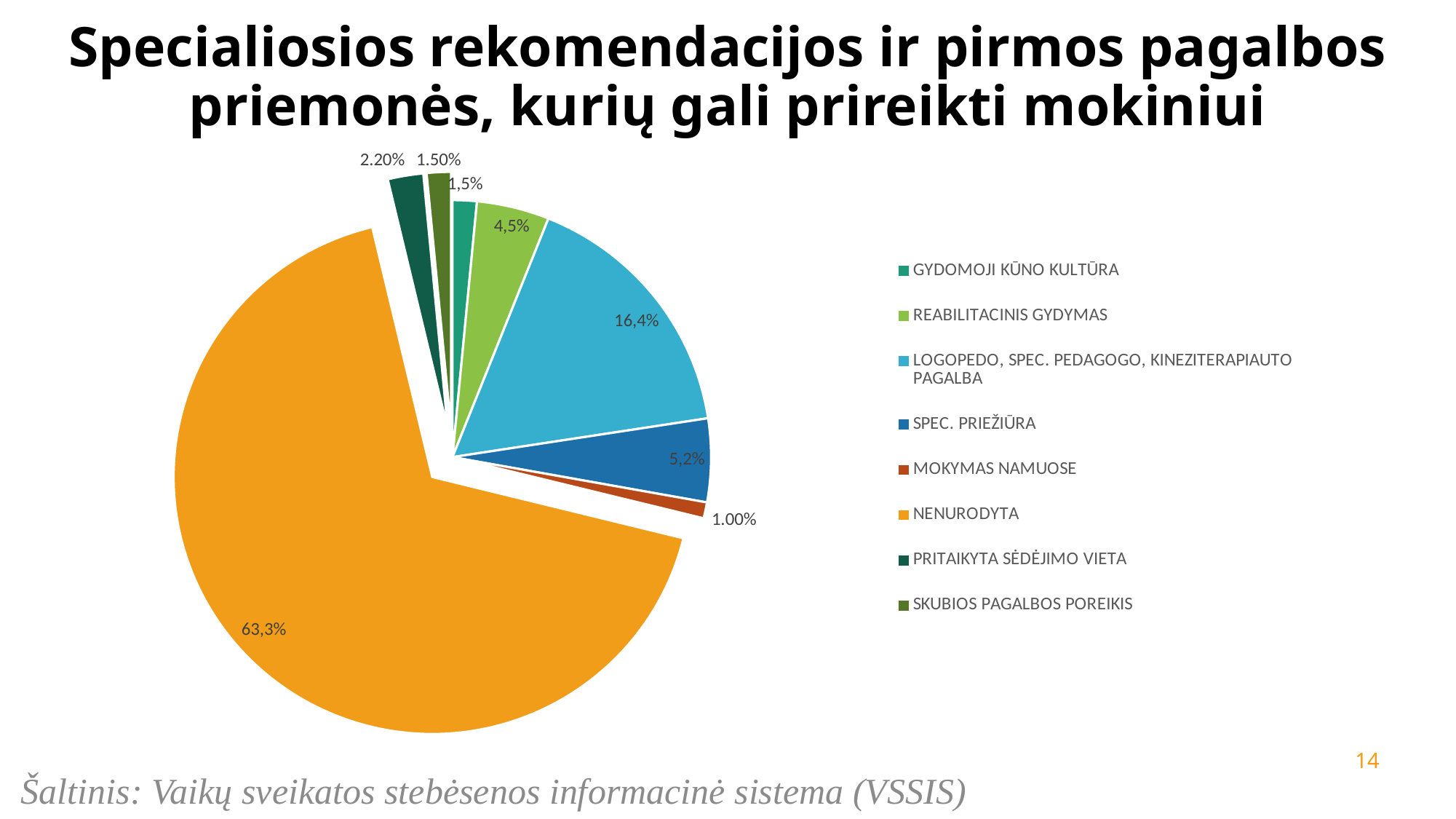
What percentage is shown for LOGOPEDO, SPEC. PEDAGOGO, KINEZITERAPIAUTO PAGALBA? 16,4% Which is larger, the share for SPEC. PRIEŽIŪRA or for REABILITACINIS GYDYMAS? SPEC. PRIEŽIŪRA What is the value of the SPEC. PRIEŽIŪRA slice? 5,2% What percentage is labelled for REABILITACINIS GYDYMAS? 4,5% How many categories does the legend list? 8 Which category has the smallest share of the pie? MOKYMAS NAMUOSE What colour is the NENURODYTA slice? orange What percentage is shown for PRITAIKYTA SĖDĖJIMO VIETA? 2.20% What kind of chart is shown on the slide? pie chart What value is shown for MOKYMAS NAMUOSE? 1.00% What percentage does the NENURODYTA slice represent? 63,3% Which category has the largest share of the pie? NENURODYTA